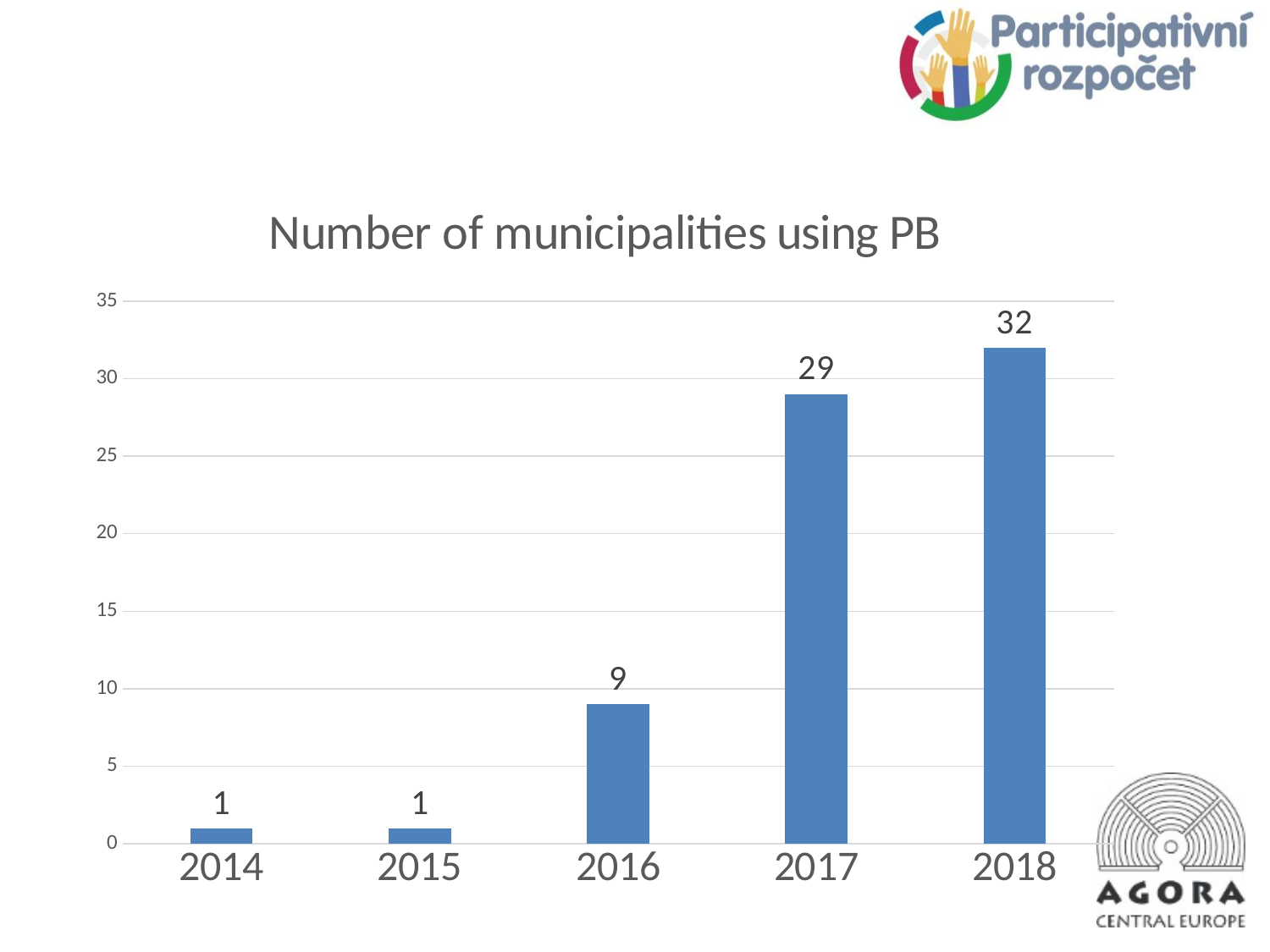
What is the number of municipalities using PB in 2014? 1 What is the title of the chart? Number of municipalities using PB What is the difference between the number of municipalities using PB in 2018 and in 2017? 3 What is the difference between the number of municipalities using PB in 2017 and in 2016? 20 Do the values rise or fall from 2014 to 2018? rise What kind of chart is shown on the slide? bar chart Which year has the highest number of municipalities using PB? 2018 Which year has more municipalities using PB, 2016 or 2017? 2017 Is the value for 2018 greater or less than 30? greater What is the number of municipalities using PB in 2017? 29 What is the number of municipalities using PB in 2016? 9 How many years are shown on the x axis of the chart? 5